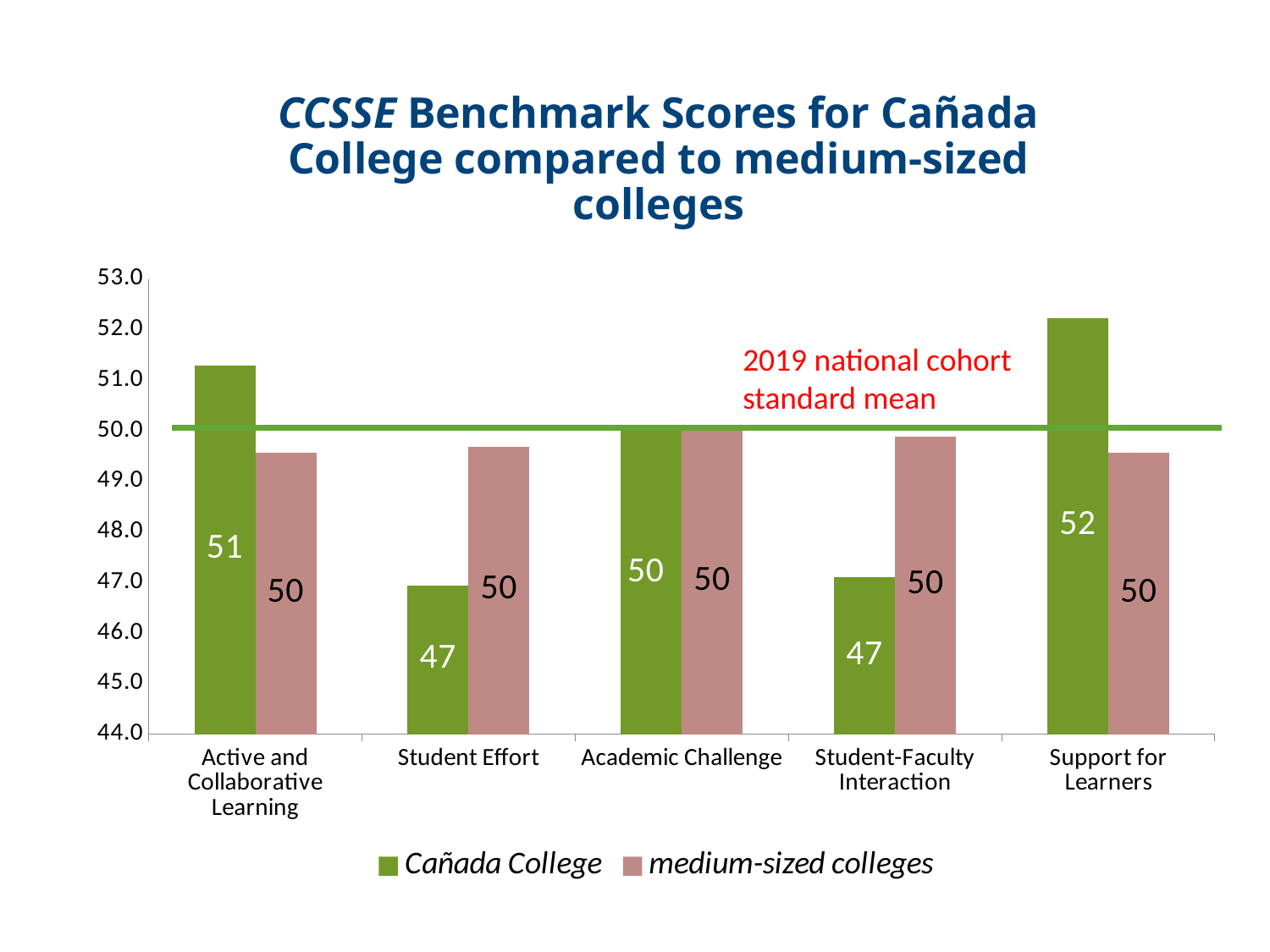
What is the Cañada College score for Active and Collaborative Learning? 51 Which benchmark has the highest Cañada College score? Support for Learners What is the difference between the Cañada College and medium-sized colleges scores for Support for Learners? 2 How many series does the legend list? 2 What is the medium-sized colleges score for Academic Challenge? 50 For Active and Collaborative Learning, which is larger: the Cañada College score or the medium-sized colleges score? Cañada College What is the Cañada College score for Student Effort? 47 What does the horizontal green line across the chart represent? 2019 national cohort standard mean What is the Cañada College score for Support for Learners? 52 Is the Cañada College value for Student Effort greater or less than 48.0? less How many benchmark categories are shown on the x axis? 5